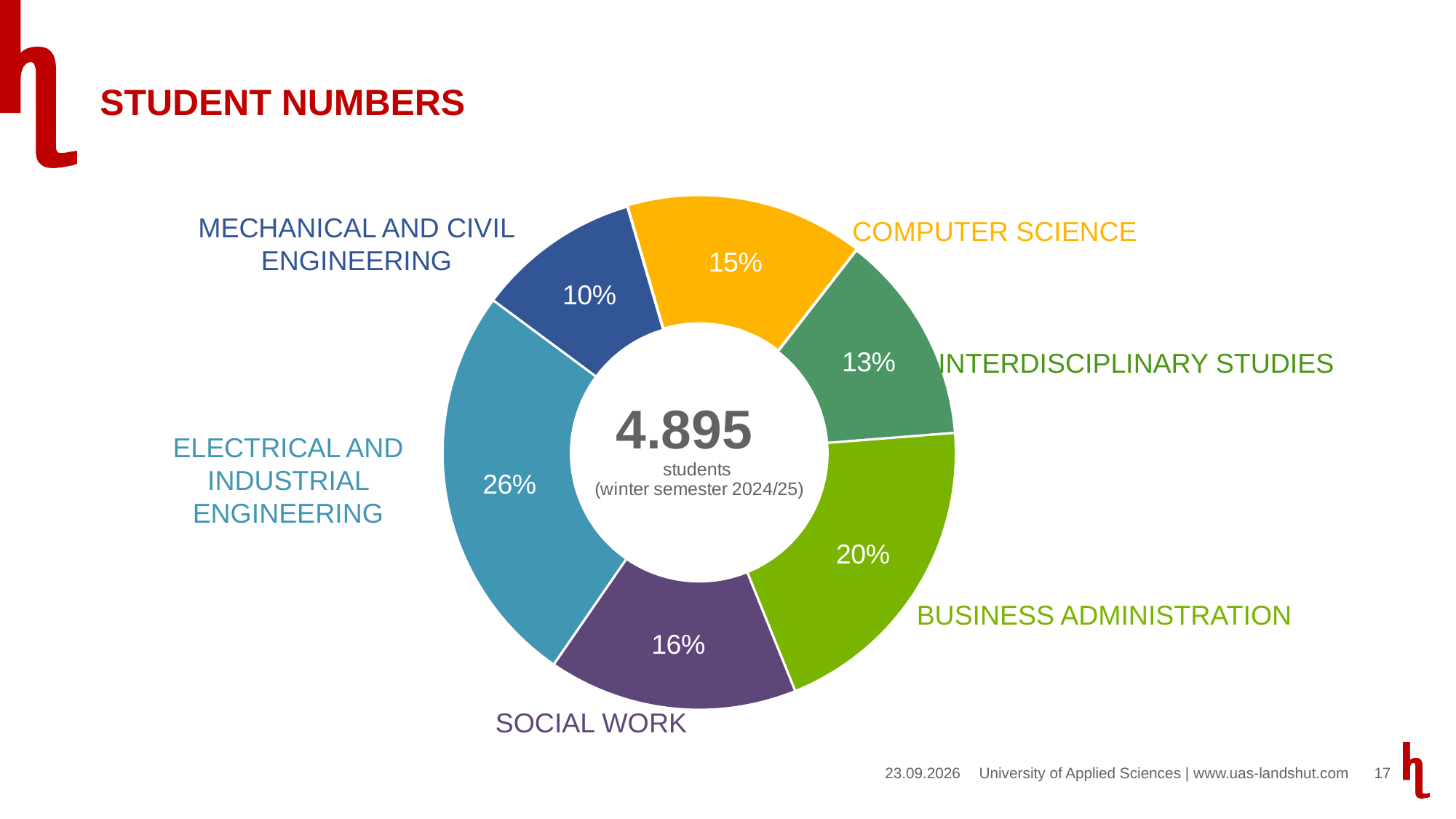
What share of students is in Electrical and Industrial Engineering? 26% What share of students is in Business Administration? 20% What kind of chart is shown on the slide? Pie chart (donut) What share of students is in Social Work? 16% Which field has the largest share of students? Electrical and Industrial Engineering What share of students is in Mechanical and Civil Engineering? 10% How many fields of study are shown in the chart? 6 What share of students is in Computer Science? 15% Which field has the smallest share of students? Mechanical and Civil Engineering What share of students is in Interdisciplinary Studies? 13% What is the difference in percentage points between Business Administration and Computer Science? 5 Which has a larger share, Social Work or Interdisciplinary Studies? Social Work